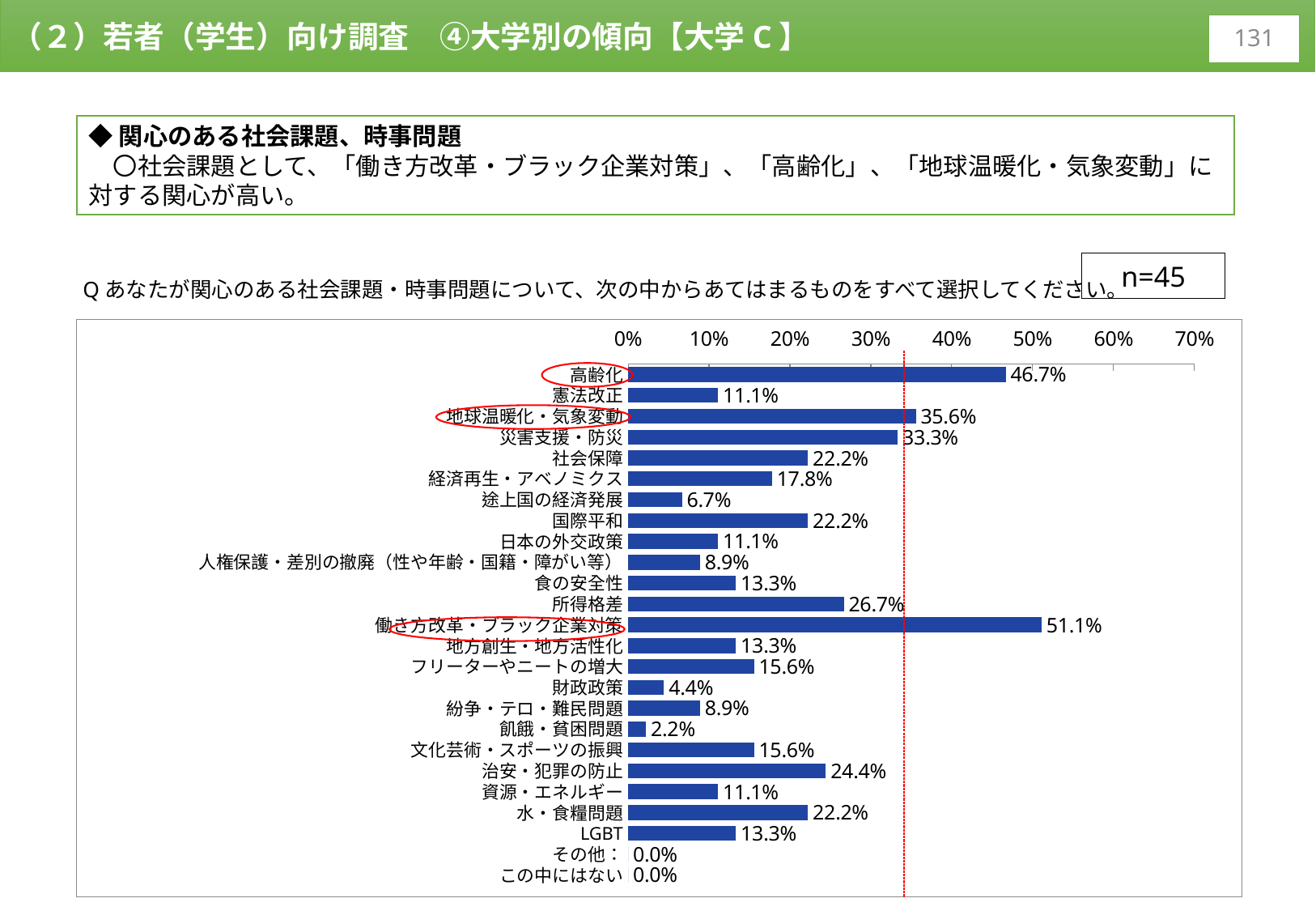
What is the value for 飢餓・貧困問題? 2.2% What is the value for 働き方改革・ブラック企業対策? 51.1% What is the value for 地球温暖化・気象変動? 35.6% What kind of chart is shown? bar chart What is the difference between 高齢化 and 地球温暖化・気象変動? 11.1% What is the sample size (n) shown on the slide? n=45 What is the value for 高齢化? 46.7% Which is larger, 災害支援・防災 or 所得格差? 災害支援・防災 How many categories are shown on the chart? 25 Is the value for 治安・犯罪の防止 greater or less than 20%? greater Which category has the highest value? 働き方改革・ブラック企業対策 Which category has the lowest non-zero value? 飢餓・貧困問題